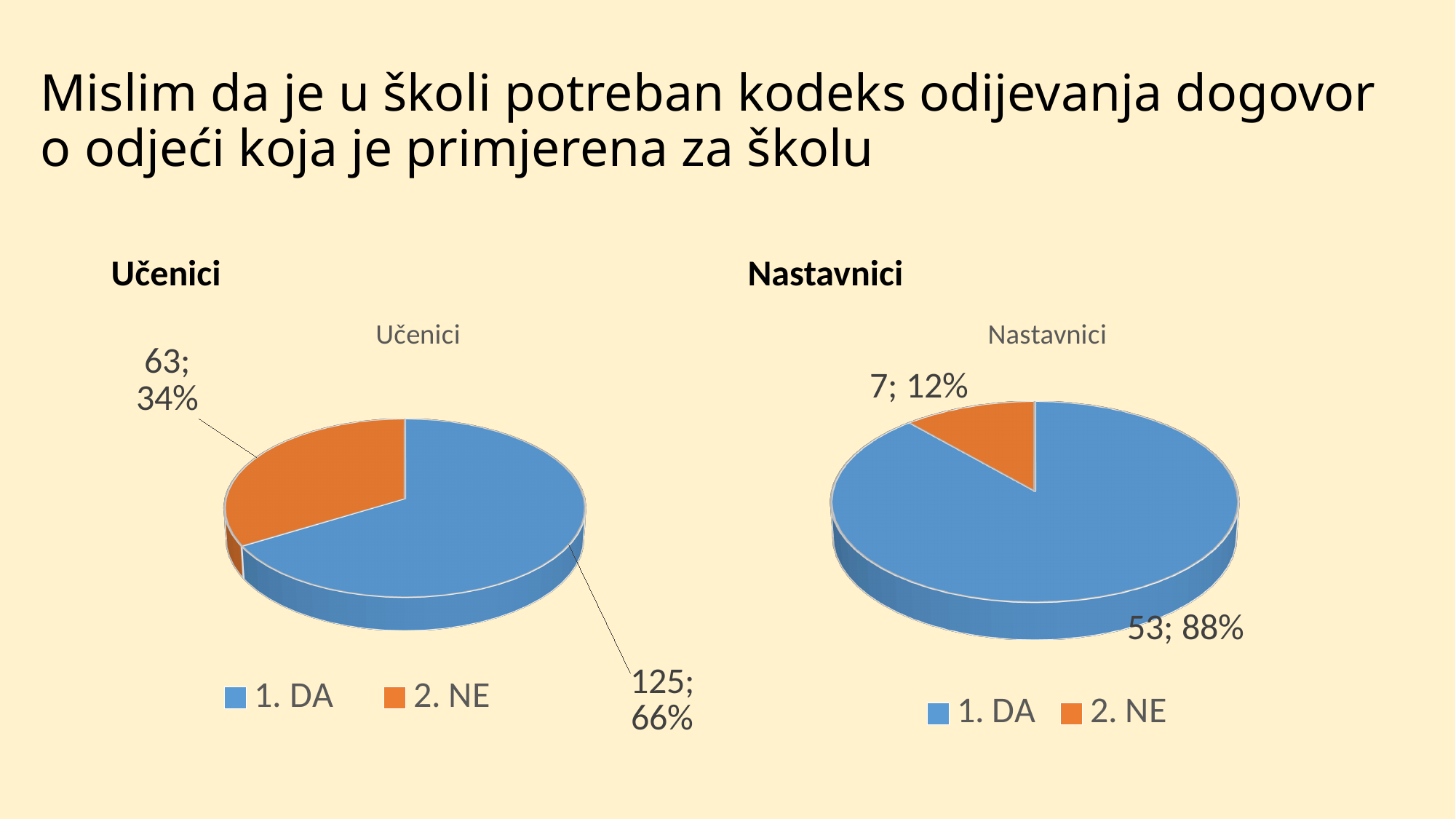
What kind of chart is the Nastavnici chart? Pie chart In the Nastavnici chart, what colour is the 2. NE slice? Orange In the Učenici chart, what share of the pie is 2. NE? 34% In the Nastavnici chart, what is the total number of responses across both slices? 60 In the Nastavnici chart, how many respondents answered 2. NE? 7 In the Učenici chart, which answer has the largest slice? 1. DA In the Učenici chart, how many respondents answered 1. DA? 125 How many slices does the Učenici pie chart have? 2 In the Nastavnici chart, which answer has the smallest slice? 2. NE In the Učenici chart, what is the difference between the number of 1. DA and 2. NE responses? 62 In the Učenici chart, is the count for 1. DA or 2. NE larger? 1. DA In the Nastavnici chart, what share of the pie is 1. DA? 88%